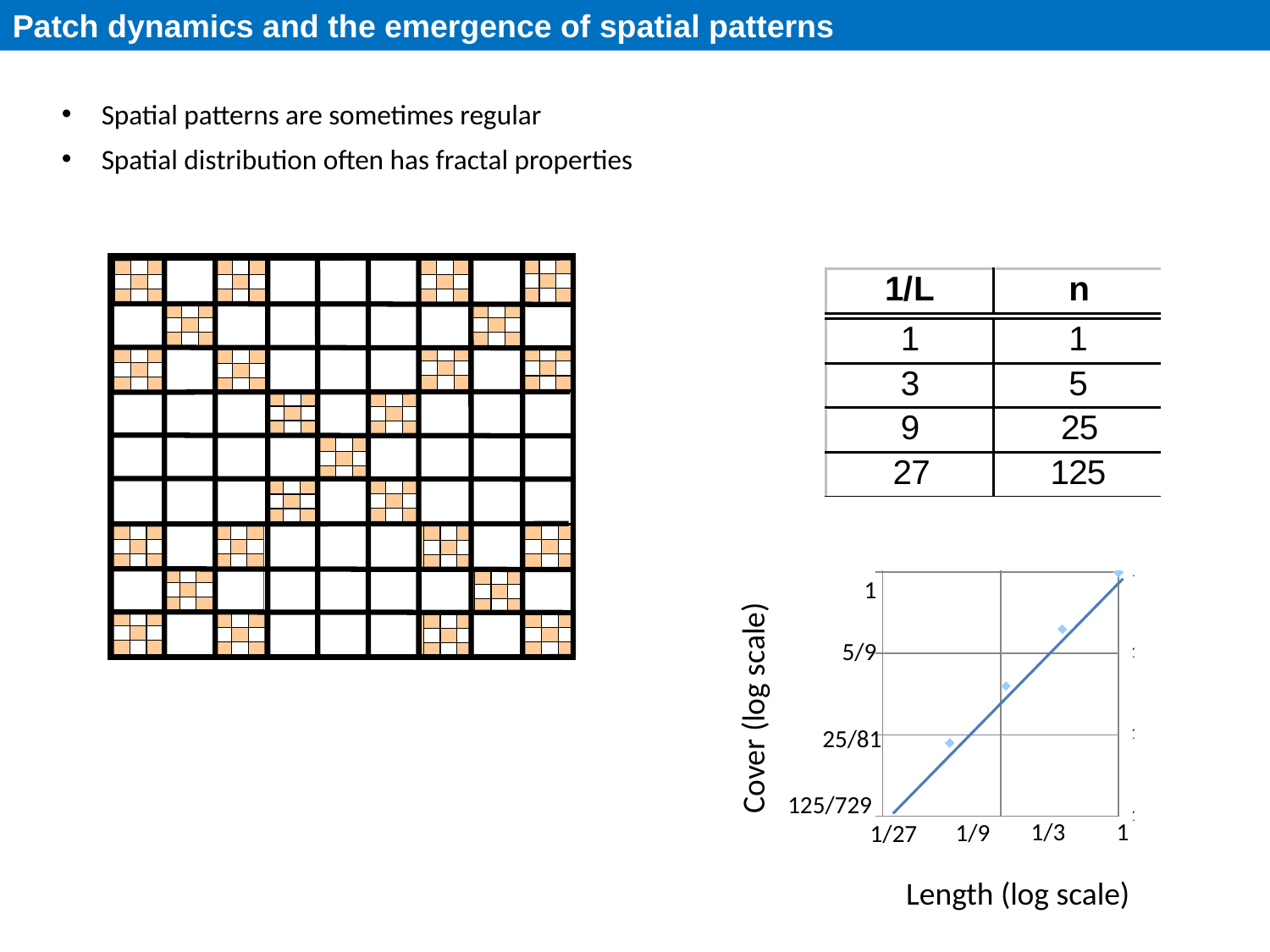
On the Cover vs Length chart, which plotted point has the lowest Cover value? The point near Length 1/27 On the Cover vs Length chart, is the Cover value for the point near Length 1/9 greater or less than 25/81? greater How many data points are plotted on the Cover vs Length chart? 4 On the Cover vs Length chart, is the Cover value for the point near Length 1/9 greater or less than 5/9? less On the Cover vs Length chart, does Cover rise or fall as Length increases along the x axis? Rises What is the label of the x axis on the chart at the bottom right? Length (log scale) On the Cover vs Length chart, which plotted point has the highest Cover value? The point at Length 1 What kind of chart is shown at the bottom right of the slide? Scatter chart with a trend line What is the label of the y axis on the chart at the bottom right? Cover (log scale) On the Cover vs Length chart, is the Cover value for the point near Length 1/3 greater or less than 5/9? greater On the Cover vs Length chart, which point has a larger Cover value: the one near Length 1/3 or the one near Length 1/9? The one near Length 1/3